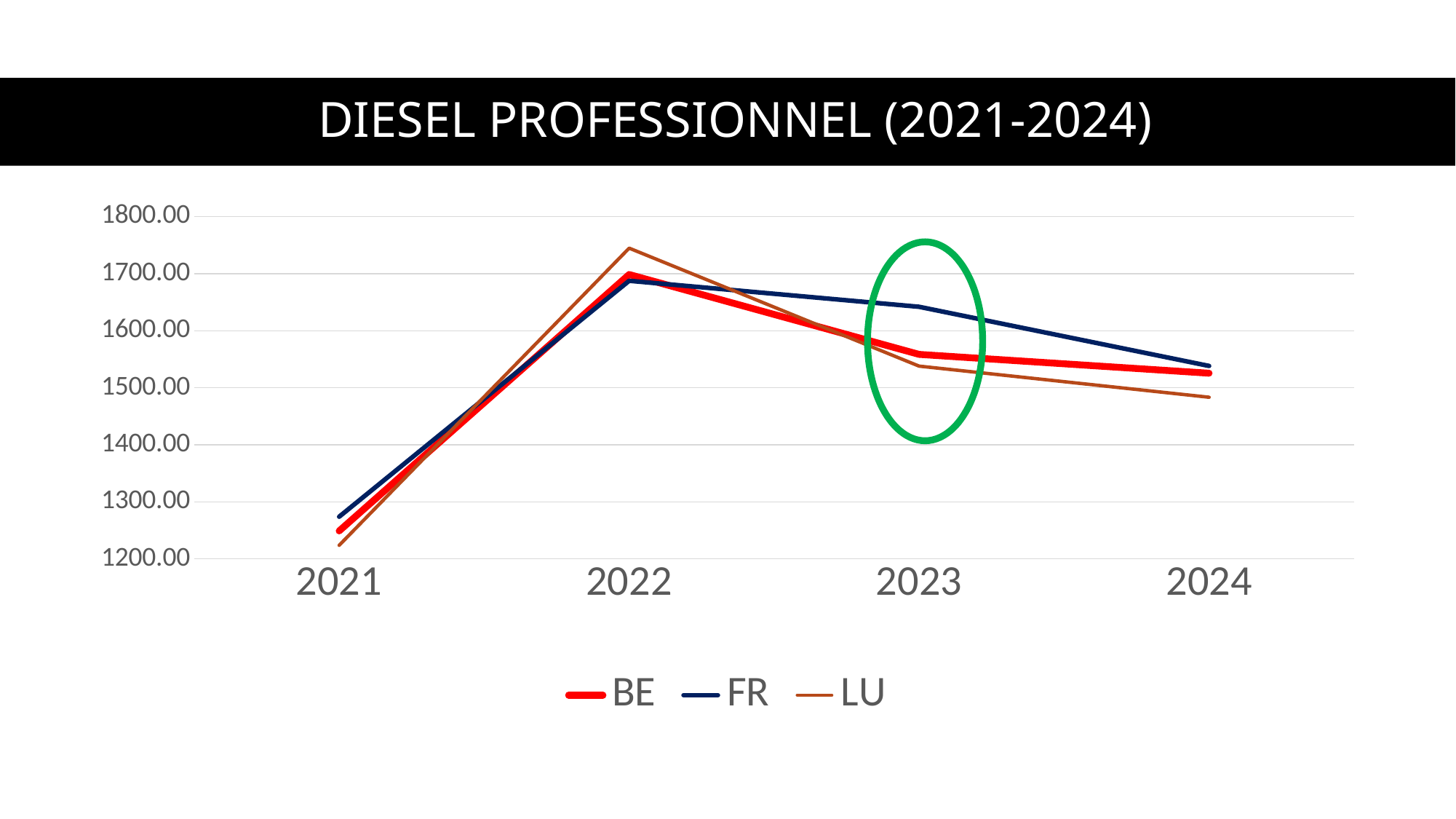
Is the value for BE in 2021 greater or less than 1300? less How many years are shown on the x axis? 4 Is the value for LU in 2024 greater or less than 1500? less Which series has the highest value in 2023? FR Is the value for FR in 2023 greater or less than 1600? greater Which year on the x axis is highlighted with a green circle? 2023 How many series does the legend list? 3 Do the values for BE rise or fall from 2022 to 2024? fall Which series has the lowest value in 2024? LU What kind of chart is shown on the slide? line chart Which series has the highest value in 2022? LU